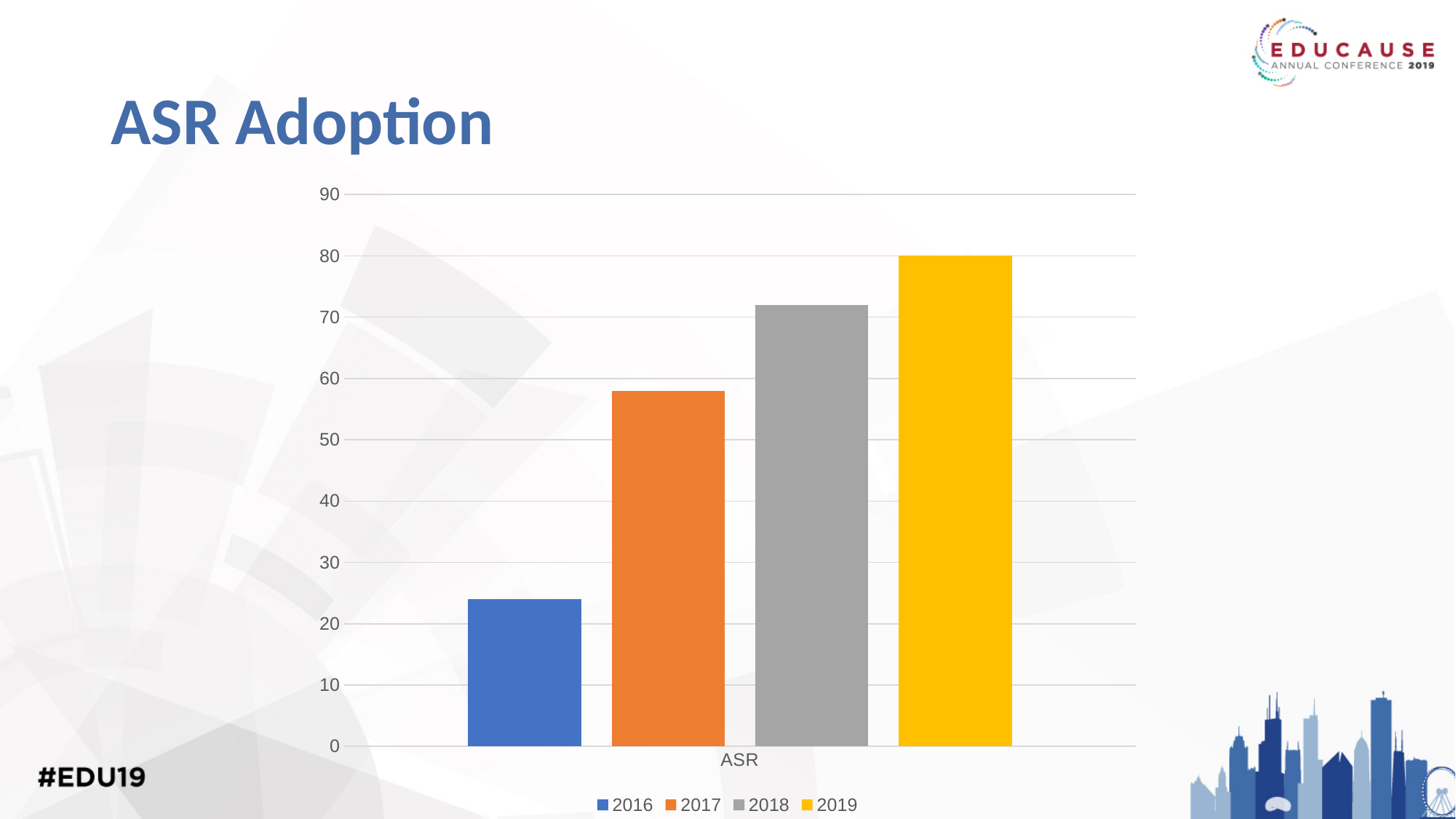
Which year has the highest bar? 2019 Is the value for 2018 greater or less than 80? less What kind of chart is shown on the slide? bar chart Is the value for 2017 greater or less than 50? greater Do the values rise or fall from 2016 to 2019? rise Is the value for 2016 greater or less than 30? less What colour is the bar for 2019? yellow What is the title of the slide containing the chart? ASR Adoption How many series does the legend list? 4 Which year has the lowest bar? 2016 How many categories are shown on the x axis? 1 Which is larger, the value for 2017 or the value for 2018? 2018